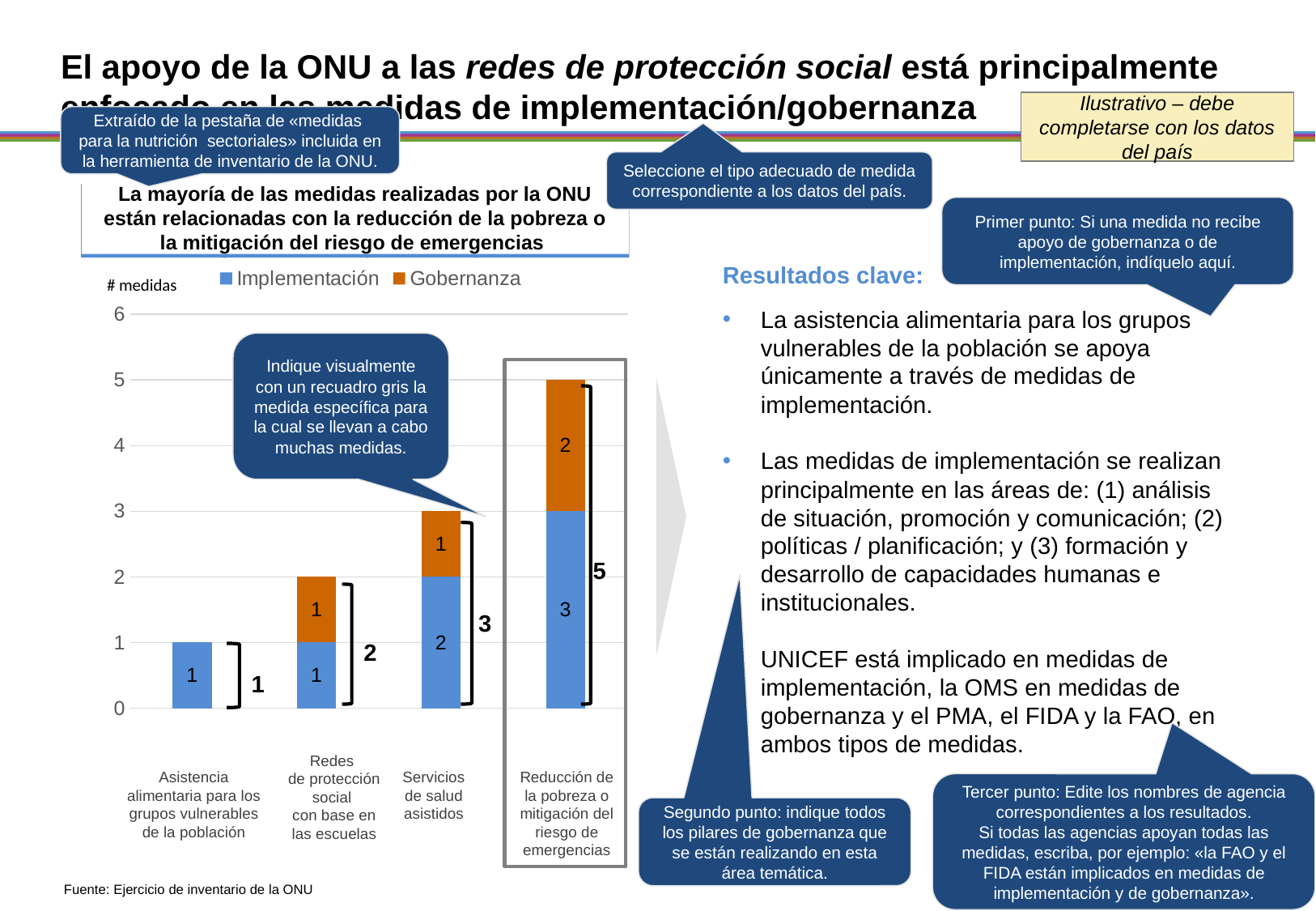
How many series does the chart legend list? 2 What is the difference between the total measures for 'Reducción de la pobreza o mitigación del riesgo de emergencias' and 'Servicios de salud asistidos'? 2 Which is larger: the Implementación value for 'Servicios de salud asistidos' or the Implementación value for 'Redes de protección social con base en las escuelas'? Servicios de salud asistidos Which category has the highest total number of measures? Reducción de la pobreza o mitigación del riesgo de emergencias What kind of chart is shown on the slide? Stacked bar chart What is the total number of measures for 'Redes de protección social con base en las escuelas'? 2 Which category has the lowest total number of measures? Asistencia alimentaria para los grupos vulnerables de la población How many categories are shown on the x axis of the chart? 4 What is the Gobernanza value for 'Servicios de salud asistidos'? 1 What are the two series named in the chart legend? Implementación and Gobernanza What is the total number of measures for 'Reducción de la pobreza o mitigación del riesgo de emergencias'? 5 What is the Implementación value for 'Reducción de la pobreza o mitigación del riesgo de emergencias'? 3